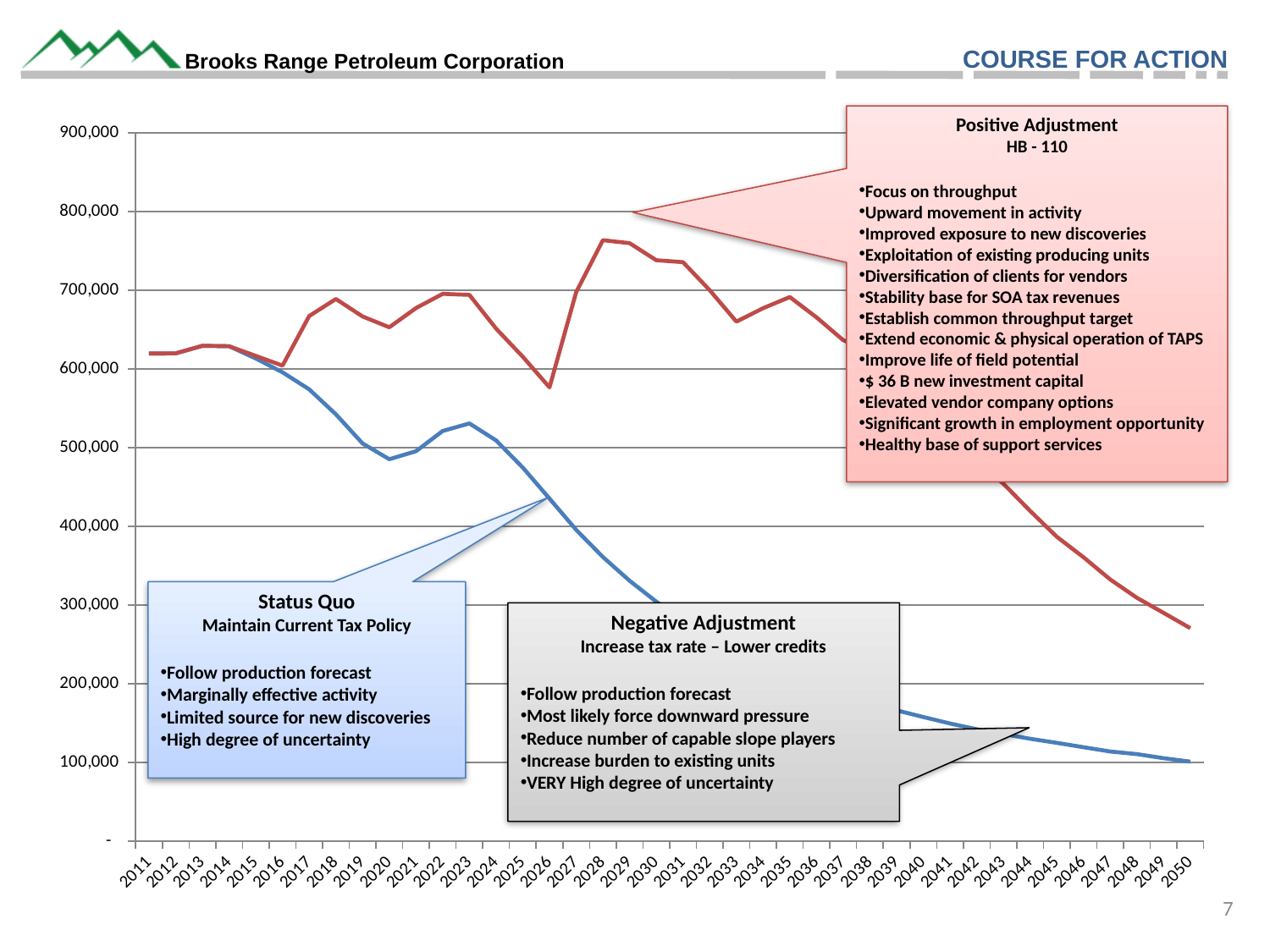
Is the value of the red line in 2028 greater or less than 700,000? greater How many years are labelled along the x axis of the chart? 40 What kind of chart is shown on the slide? line chart Is the value of the blue line in 2050 greater or less than 200,000? less What is the first year shown on the x axis? 2011 In 2030, which line has the higher value, the red line or the blue line? red line What is the highest value labelled on the y axis? 900,000 Is the value of the red line in 2050 greater or less than 300,000? less Does the blue line rise or fall overall from 2011 to 2050? fall